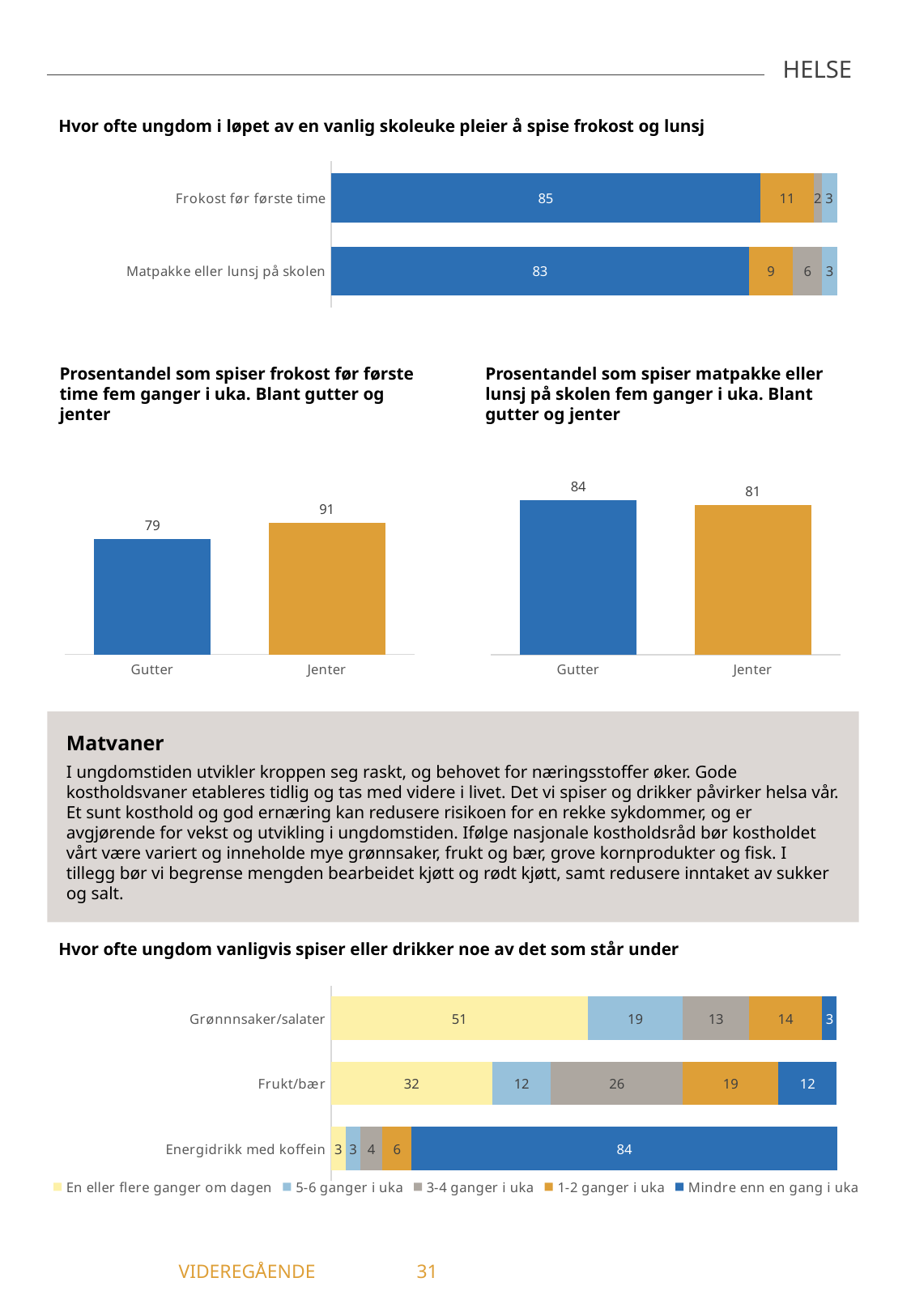
In the chart 'Hvor ofte ungdom i løpet av en vanlig skoleuke pleier å spise frokost og lunsj', what is the value of the largest (blue) segment for 'Frokost før første time'? 85 In the chart 'Prosentandel som spiser frokost før første time fem ganger i uka', what is the difference between Jenter and Gutter? 12 In the chart 'Prosentandel som spiser matpakke eller lunsj på skolen fem ganger i uka', what is the value for Gutter? 84 In the chart 'Hvor ofte ungdom i løpet av en vanlig skoleuke pleier å spise frokost og lunsj', what is the total of the stacked bar for 'Matpakke eller lunsj på skolen'? 101 In the chart 'Hvor ofte ungdom vanligvis spiser eller drikker noe av det som står under', how many series does the legend list? 5 In the chart 'Prosentandel som spiser matpakke eller lunsj på skolen fem ganger i uka', which group has the higher value, Gutter or Jenter? Gutter In the chart 'Hvor ofte ungdom i løpet av en vanlig skoleuke pleier å spise frokost og lunsj', how many categories are shown? 2 In the chart 'Hvor ofte ungdom vanligvis spiser eller drikker noe av det som står under', what is the value for 'En eller flere ganger om dagen' for Frukt/bær? 32 In the chart 'Prosentandel som spiser frokost før første time fem ganger i uka', what is the value for Jenter? 91 What kind of chart is 'Prosentandel som spiser frokost før første time fem ganger i uka'? Bar chart In the chart 'Hvor ofte ungdom vanligvis spiser eller drikker noe av det som står under', which category has the highest value for 'Mindre enn en gang i uka'? Energidrikk med koffein In the chart 'Hvor ofte ungdom vanligvis spiser eller drikker noe av det som står under', what is the difference between the '3-4 ganger i uka' values for Frukt/bær and Grønnnsaker/salater? 13